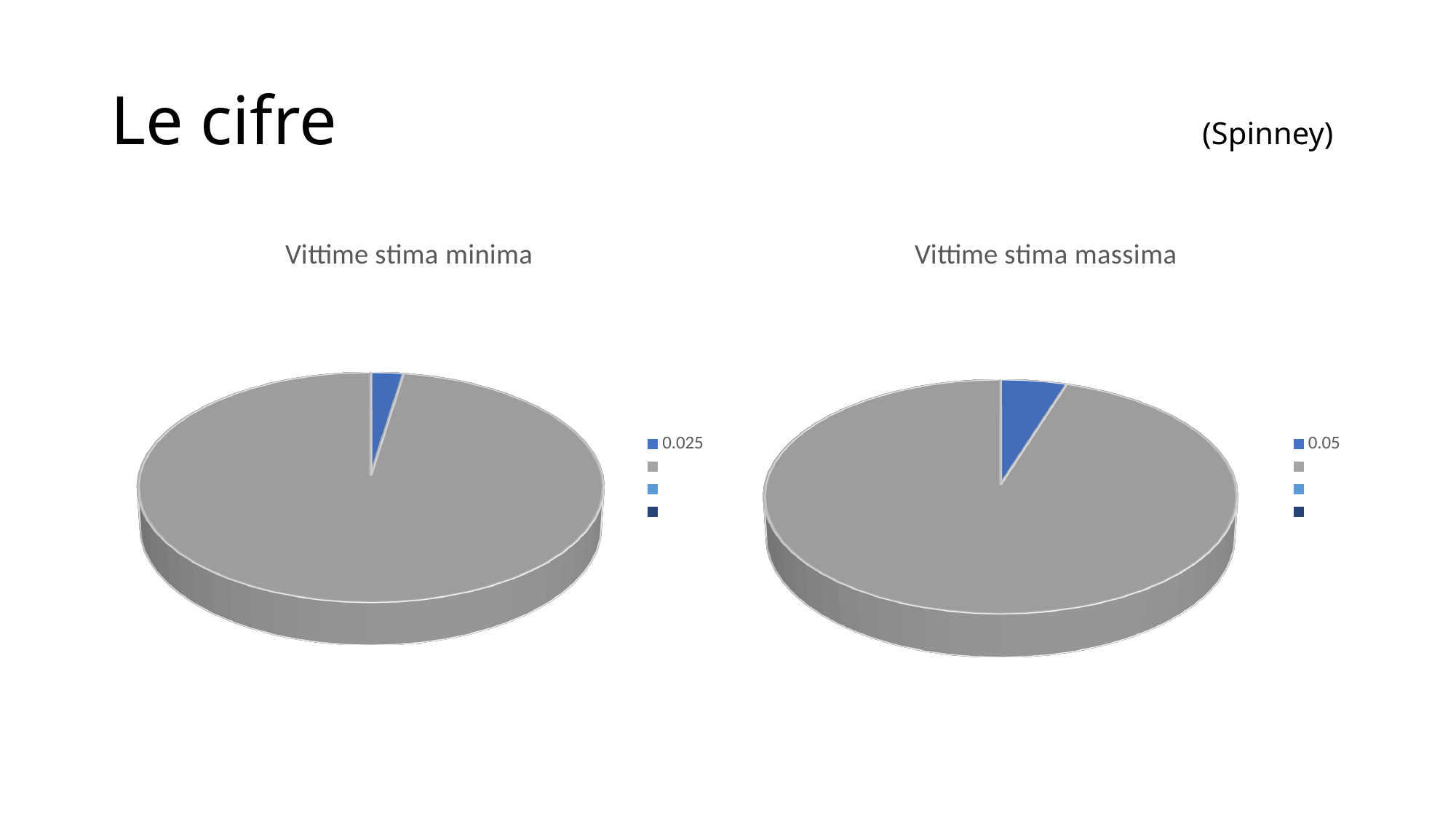
What is the title of the left pie chart? Vittime stima minima What is the title of the right pie chart? Vittime stima massima What kind of chart is the left chart titled "Vittime stima minima"? pie chart In the "Vittime stima massima" chart, which slice is larger, the blue one or the grey one? the grey one Comparing the two pie charts, in which chart is the blue slice larger? Vittime stima massima How many slices are visible in the "Vittime stima minima" pie chart? 2 In the "Vittime stima minima" chart, which slice is larger, the blue one or the grey one? the grey one In the "Vittime stima massima" chart, what label does the legend give the blue slice? 0.05 In the "Vittime stima minima" chart, what label does the legend give the blue slice? 0.025 How many slices are visible in the "Vittime stima massima" pie chart? 2 What kind of chart is the right chart titled "Vittime stima massima"? pie chart